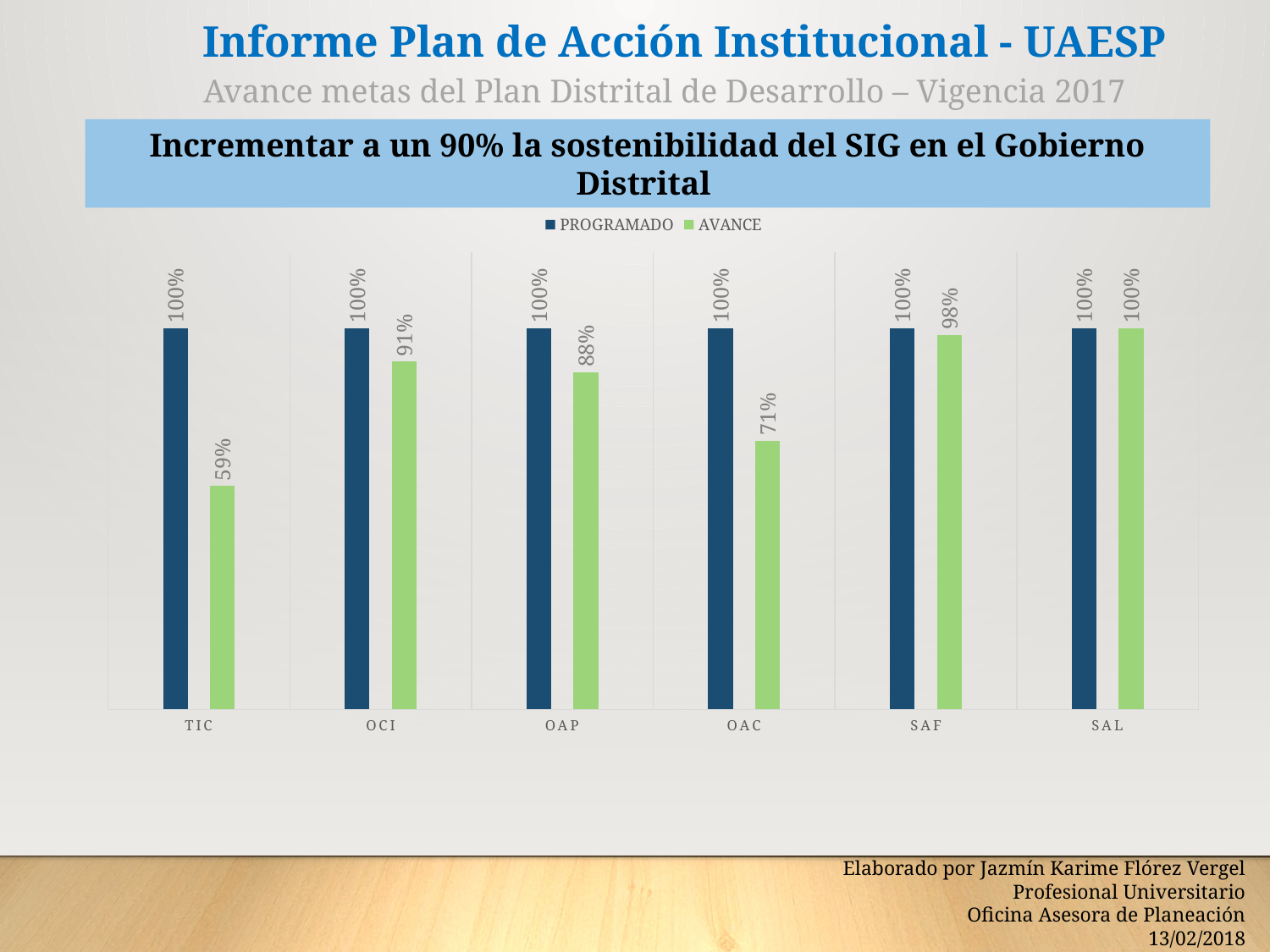
What is the difference between the PROGRAMADO and AVANCE values for OAP? 12% How many series does the legend list? 2 Which category has the highest AVANCE value? SAL What is the AVANCE value for OAC? 71% Which is larger, the AVANCE value for OCI or the AVANCE value for OAC? OCI What is the AVANCE value for TIC? 59% What kind of chart is shown on the slide? Bar chart What is the PROGRAMADO value for OCI? 100% Which series is shown in green? AVANCE How many categories are shown on the x axis? 6 What is the AVANCE value for SAF? 98% Which category has the lowest AVANCE value? TIC